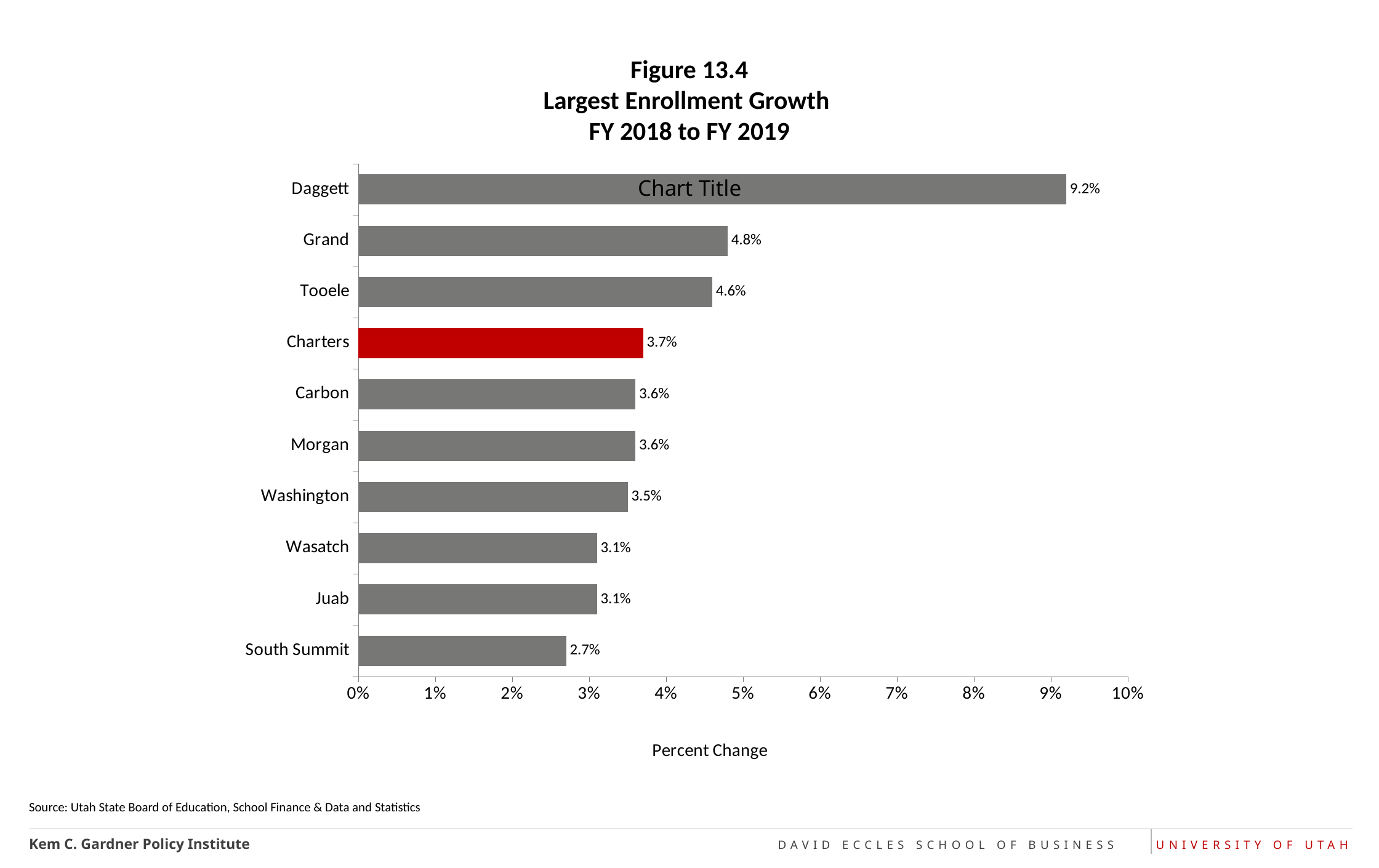
What is the percent change for Tooele? 4.6% Is the value for Tooele greater or less than 4%? greater What is the difference between the percent change for Daggett and Grand? 4.4% How many categories are shown in the chart? 10 What is the percent change for South Summit? 2.7% What is the percent change for Charters? 3.7% Which has a larger percent change, Grand or Washington? Grand Which category has the lowest percent change? South Summit Which category has the highest percent change? Daggett What kind of chart is shown on the slide? Bar chart Which bar is highlighted in red? Charters What is the percent change for Daggett? 9.2%